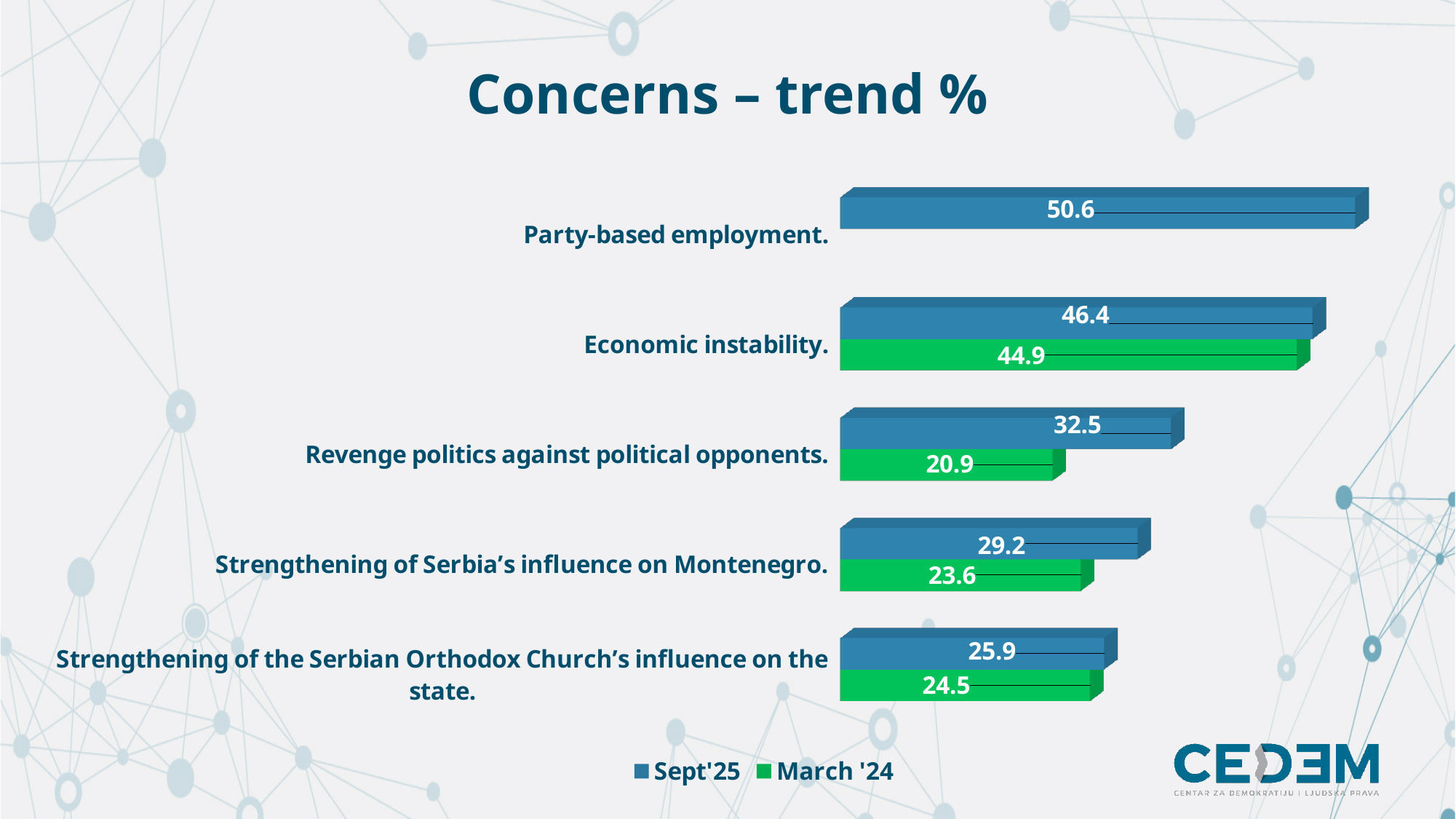
How many series does the legend list? 2 What is the March '24 value for Economic instability? 44.9 Which category has the highest Sept'25 value? Party-based employment. How many categories are shown in the chart? 5 What is the Sept'25 value for Revenge politics against political opponents? 32.5 What is the Sept'25 value for Party-based employment? 50.6 What is the March '24 value for Strengthening of the Serbian Orthodox Church's influence on the state? 24.5 Which category has the lowest March '24 value? Revenge politics against political opponents. Which is larger for Strengthening of Serbia's influence on Montenegro: the Sept'25 value or the March '24 value? Sept'25 What is the difference between the Sept'25 and March '24 values for Revenge politics against political opponents? 11.6 What kind of chart is shown on the slide? Bar chart What is the title of the chart? Concerns – trend %